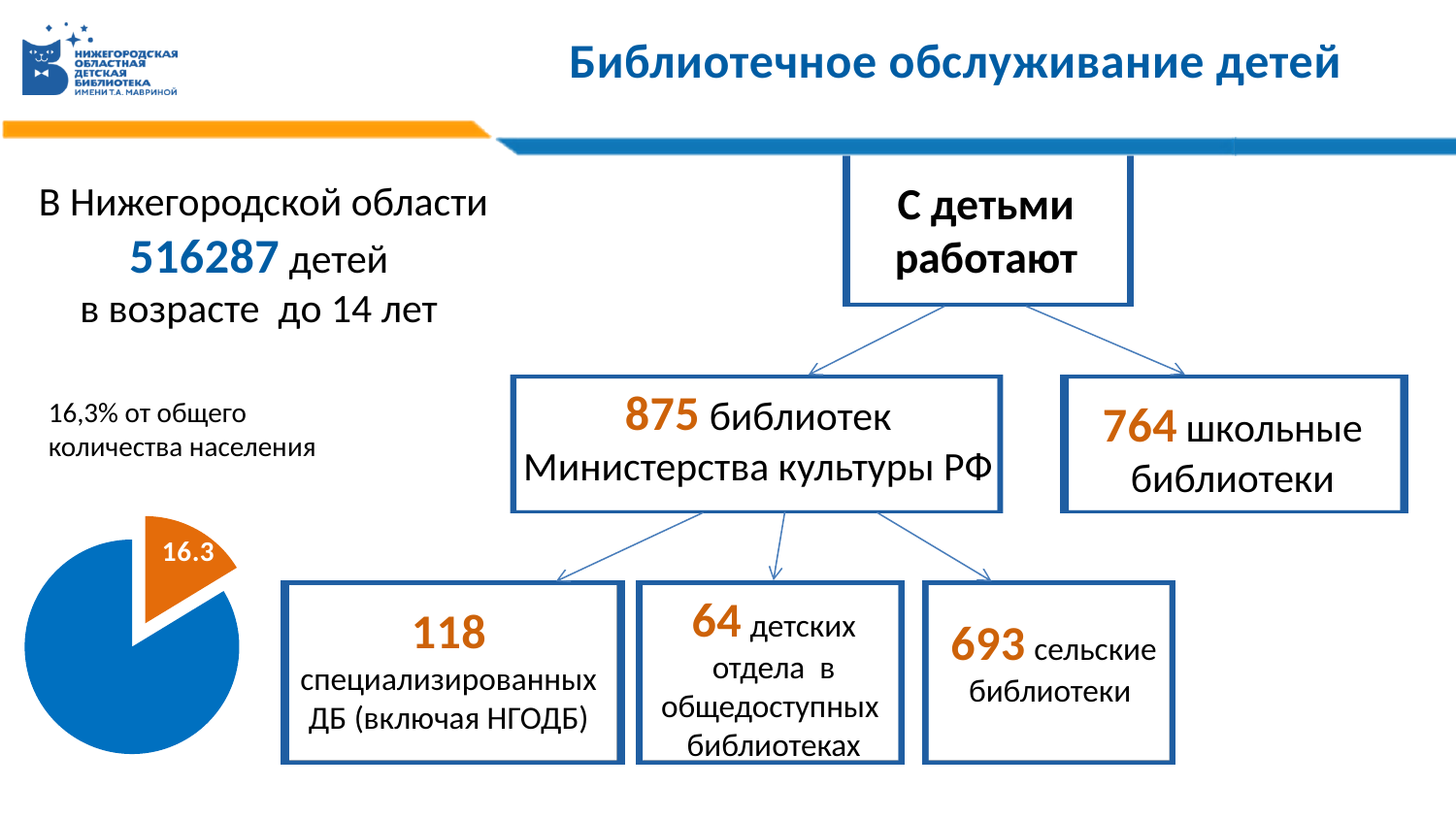
What colour is the slice labelled 16.3 in the pie chart? orange Which slice of the pie chart is the smallest? the orange slice (16.3) Which slice of the pie chart is larger, the blue one or the orange one? the blue one Is the labelled slice of the pie chart pulled out (exploded) from the rest of the pie? yes Is the value of the orange slice greater or less than 50? less What kind of chart is shown on the slide? pie chart What value is printed on the orange slice of the pie chart? 16.3 How many slices does the pie chart have? 2 What share of the pie does the orange slice represent? 16.3